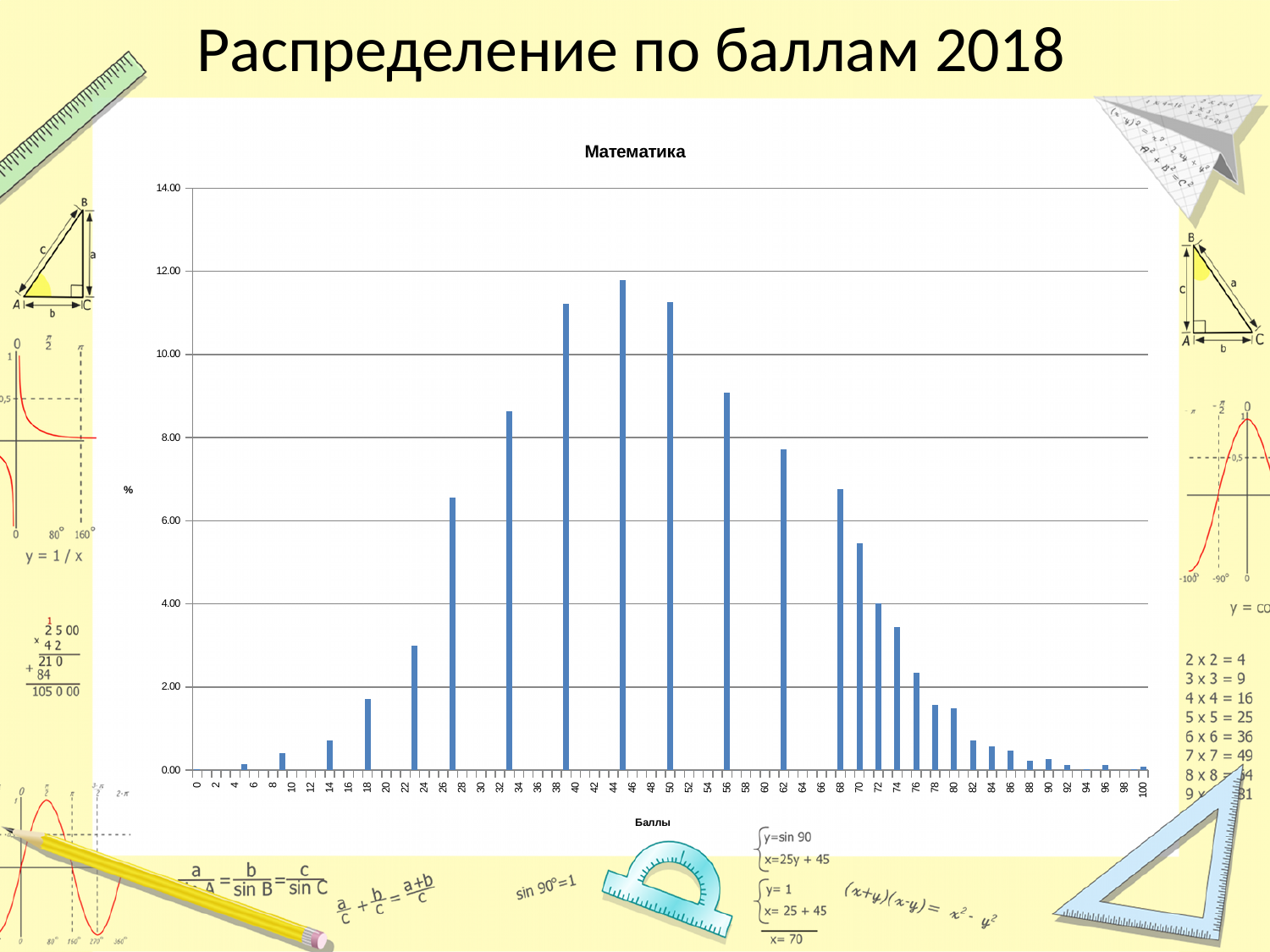
Is the value for score 70 greater or less than 6.00? less Is the value for score 74 greater or less than 4.00? less Is the value for score 18 greater or less than 2.00? less Do the values rise or fall as the score increases from 62 to 80? fall What is the label of the horizontal axis of the chart? Баллы Which has the higher value: score 62 or score 68? 62 Which has the higher value: score 14 or score 18? 18 What kind of chart is shown on the slide? bar chart What is the title of the chart? Математика